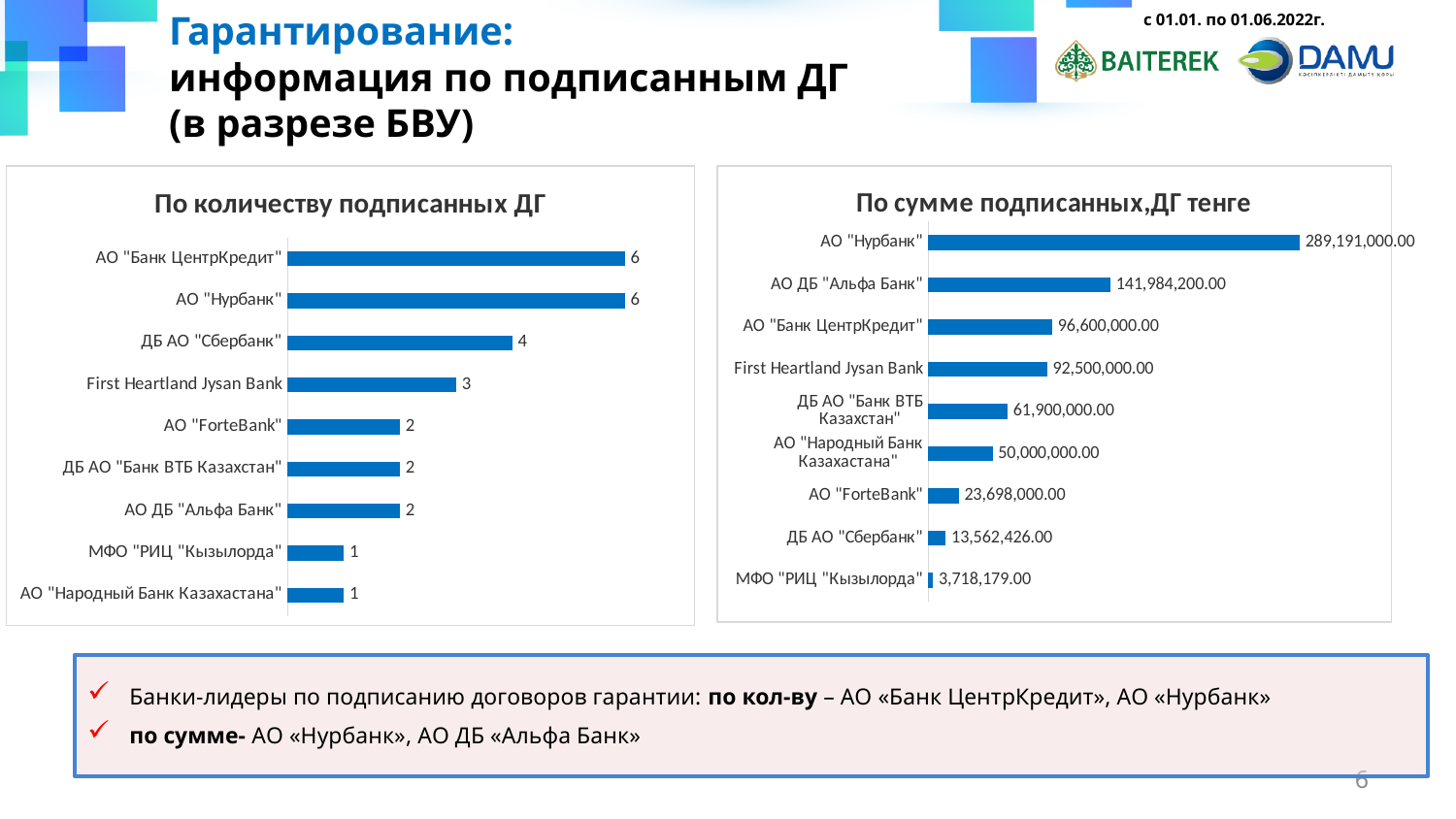
In the chart "По сумме подписанных,ДГ тенге", what is the value for ДБ АО "Банк ВТБ Казахстан"? 61,900,000.00 In the chart "По сумме подписанных,ДГ тенге", which category has the lowest value? МФО "РИЦ "Кызылорда" What is the title of the chart on the left side of the slide? По количеству подписанных ДГ In the chart "По сумме подписанных,ДГ тенге", what is the value for АО ДБ "Альфа Банк"? 141,984,200.00 In the chart "По количеству подписанных ДГ", what is the value for First Heartland Jysan Bank? 3 In the chart "По сумме подписанных,ДГ тенге", which is larger: the value for АО "Банк ЦентрКредит" or First Heartland Jysan Bank? АО "Банк ЦентрКредит" What kind of chart is "По сумме подписанных,ДГ тенге"? Bar chart In the chart "По количеству подписанных ДГ", what is the difference between the values for АО "Нурбанк" and АО "ForteBank"? 4 In the chart "По количеству подписанных ДГ", how many categories are shown? 9 In the chart "По сумме подписанных,ДГ тенге", what is the difference between the values for АО "Нурбанк" and АО ДБ "Альфа Банк"? 147,206,800.00 In the chart "По сумме подписанных,ДГ тенге", which category has the highest value? АО "Нурбанк" In the chart "По количеству подписанных ДГ", what is the value for ДБ АО "Сбербанк"? 4